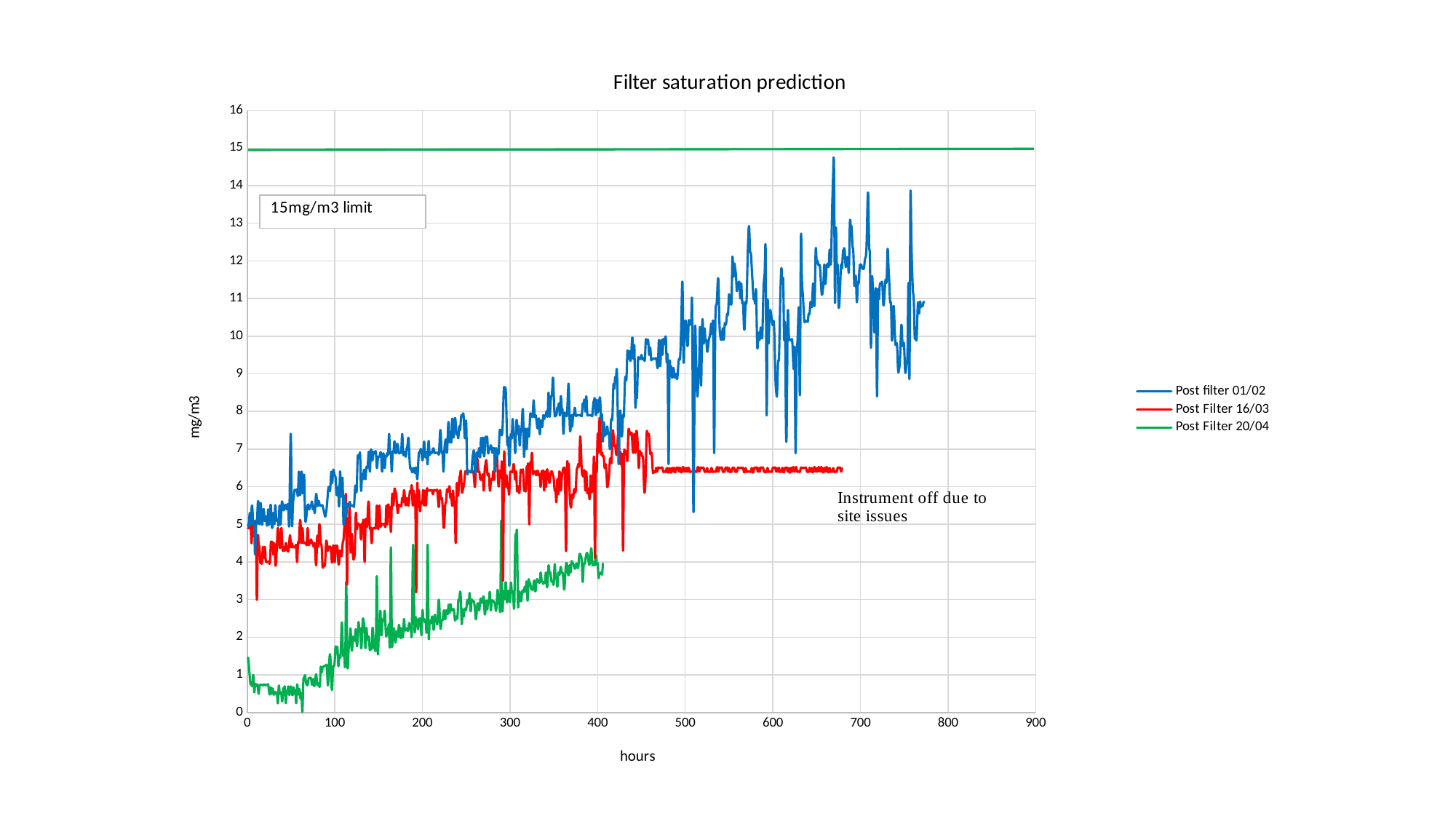
What is the title of the chart? Filter saturation prediction Which series reaches the highest value on the chart? Post filter 01/02 Does the Post filter 01/02 series generally rise or fall as hours increase? rise At 300 hours, which series has the higher value, Post filter 01/02 or Post Filter 20/04? Post filter 01/02 Is the value for Post filter 01/02 at 700 hours greater or less than 10? greater How many series does the legend list? 3 What kind of chart is shown on the slide? line chart Is the value for Post Filter 16/03 at 600 hours greater or less than 8? less Does the Post Filter 20/04 series generally rise or fall as hours increase? rise What is the label on the y axis of the chart? mg/m3 Is the value for Post Filter 20/04 at 100 hours greater or less than 3? less Which series has the lowest values on the chart? Post Filter 20/04